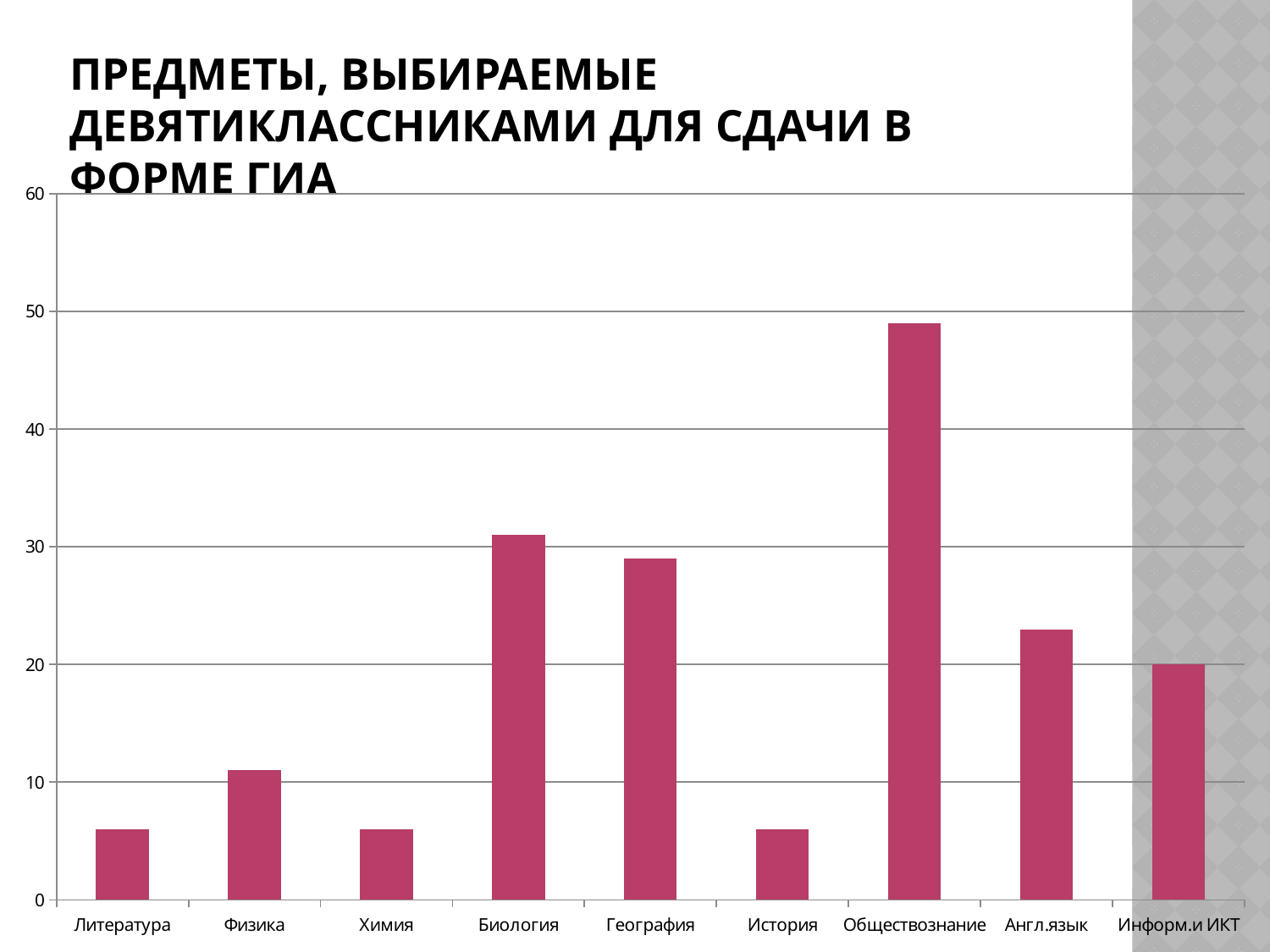
Which is larger, the value for Биология or the value for Химия? Биология Which subject has the highest bar in the chart? Обществознание Is the value for Литература greater or less than 10? less Is the value for История greater or less than 10? less How many subjects (categories) are shown on the x axis of the chart? 9 Is the value for Англ.язык greater or less than 20? greater What is the title of the chart on the slide? ПРЕДМЕТЫ, ВЫБИРАЕМЫЕ ДЕВЯТИКЛАССНИКАМИ ДЛЯ СДАЧИ В ФОРМЕ ГИА What kind of chart is shown on the slide? bar chart Which is larger, the value for Обществознание or the value for Англ.язык? Обществознание